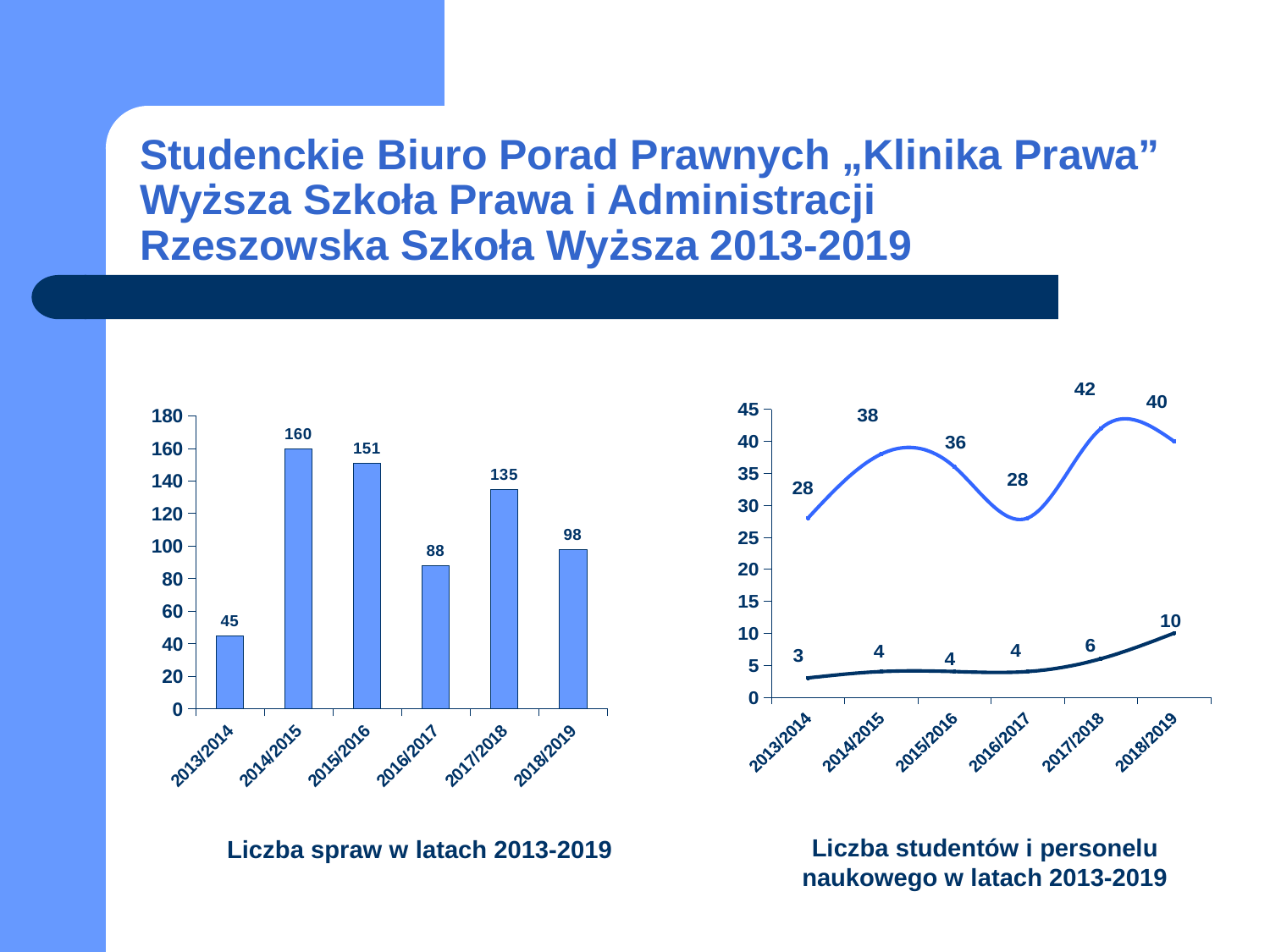
In the left chart (Liczba spraw w latach 2013-2019), how many years are shown on the x axis? 6 In the right chart (Liczba studentów i personelu naukowego w latach 2013-2019), what is the value of the upper line for 2017/2018? 42 In the left chart (Liczba spraw w latach 2013-2019), which year has the lowest value? 2013/2014 In the left chart (Liczba spraw w latach 2013-2019), which year has the highest value? 2014/2015 In the left chart (Liczba spraw w latach 2013-2019), what is the value for 2016/2017? 88 In the left chart (Liczba spraw w latach 2013-2019), what is the difference between the values for 2014/2015 and 2013/2014? 115 What kind of chart is the left chart (Liczba spraw w latach 2013-2019)? bar chart In the right chart (Liczba studentów i personelu naukowego w latach 2013-2019), what is the difference between the upper line and the lower line for 2013/2014? 25 In the left chart (Liczba spraw w latach 2013-2019), which is larger, the value for 2017/2018 or the value for 2018/2019? 2017/2018 In the left chart (Liczba spraw w latach 2013-2019), what is the value for 2014/2015? 160 In the right chart (Liczba studentów i personelu naukowego w latach 2013-2019), what is the value of the lower line for 2018/2019? 10 What kind of chart is the right chart (Liczba studentów i personelu naukowego w latach 2013-2019)? line chart